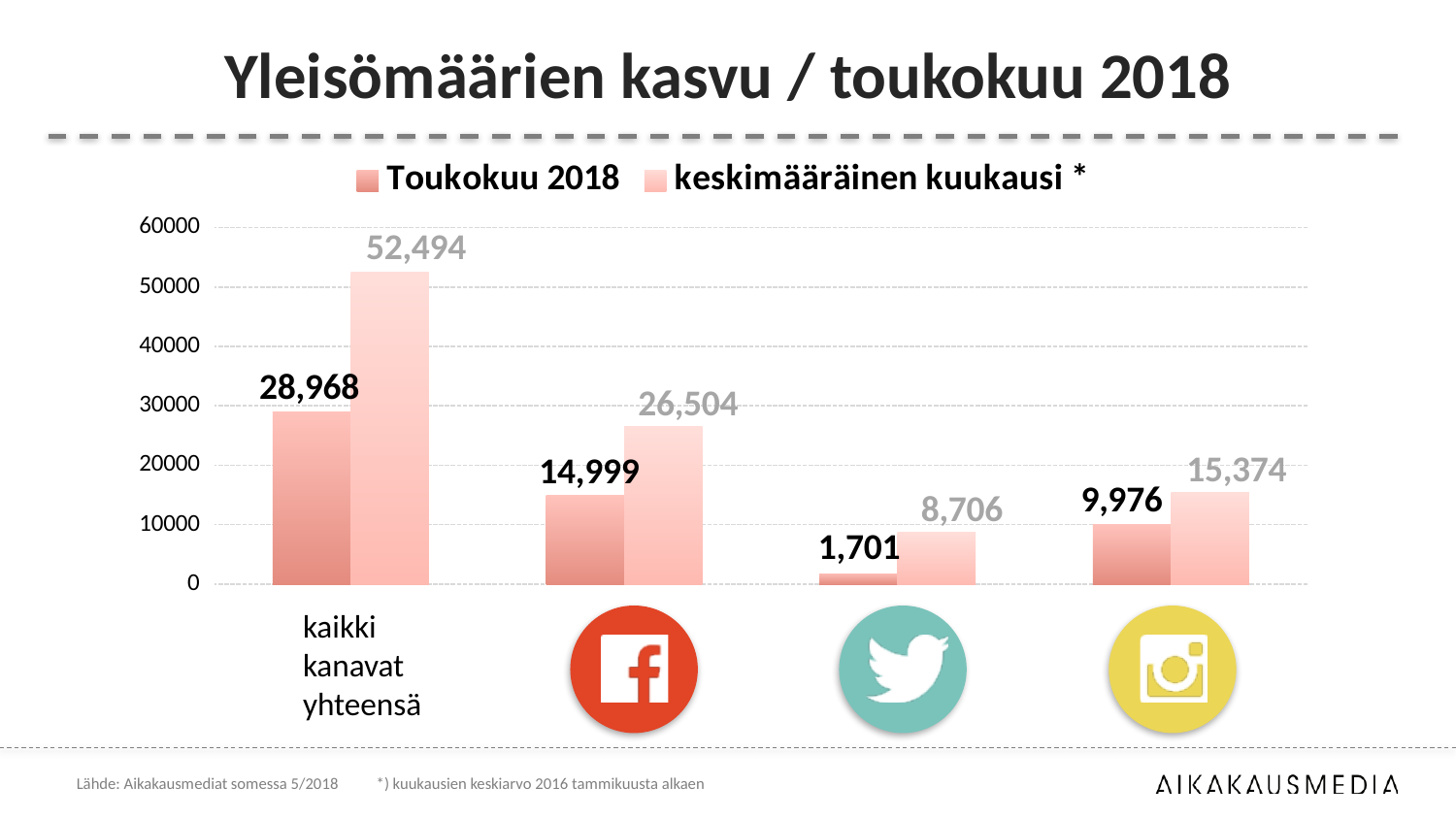
What is the Toukokuu 2018 value for the Facebook category? 14,999 What is the value for Toukokuu 2018 for the category 'kaikki kanavat yhteensä'? 28,968 What is the Toukokuu 2018 value for the Instagram category? 9,976 Which category has the highest 'keskimääräinen kuukausi *' value? kaikki kanavat yhteensä What kind of chart is shown on the slide? bar chart Which is larger for the Instagram category: the Toukokuu 2018 value or the 'keskimääräinen kuukausi *' value? keskimääräinen kuukausi * How many categories are shown on the x axis? 4 What is the difference between the 'keskimääräinen kuukausi *' value and the Toukokuu 2018 value for the Facebook category? 11,505 What is the 'keskimääräinen kuukausi *' value for the Twitter category? 8,706 Which category has the lowest Toukokuu 2018 value? Twitter What is the value for 'keskimääräinen kuukausi *' for the category 'kaikki kanavat yhteensä'? 52,494 How many series does the legend list? 2